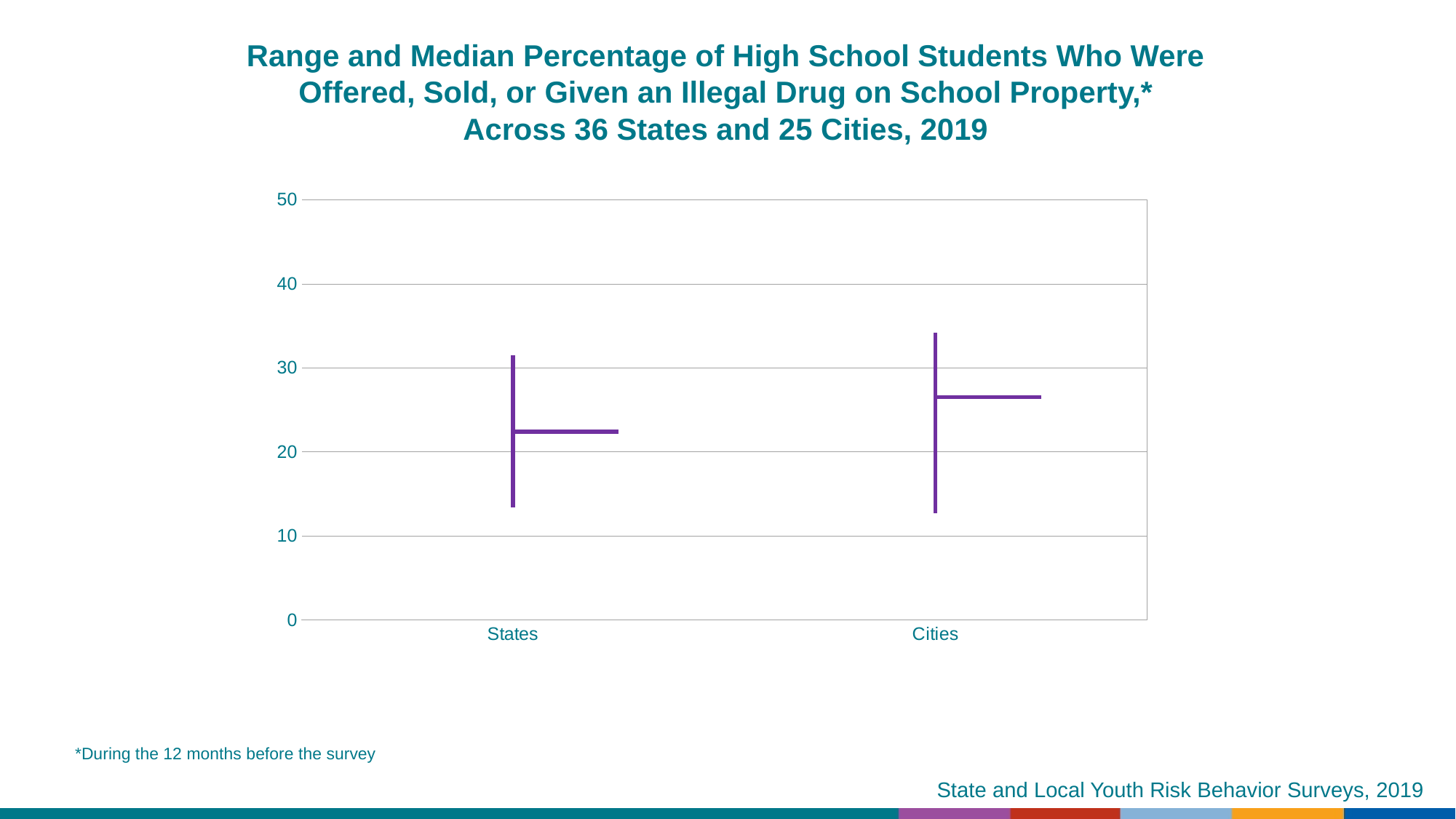
How many categories are shown on the x axis of the chart? 2 What is the maximum value shown on the y axis? 50 Is the bottom of the range for States greater or less than 20? less Which category has the higher upper end of its range, States or Cities? Cities What kind of chart is shown on the slide? high-low range chart Which category has the higher median percentage, States or Cities? Cities According to the chart title, how many states and cities are covered? 36 States and 25 Cities Is the median value for Cities greater or less than 30? less Is the median value for States greater or less than 20? greater